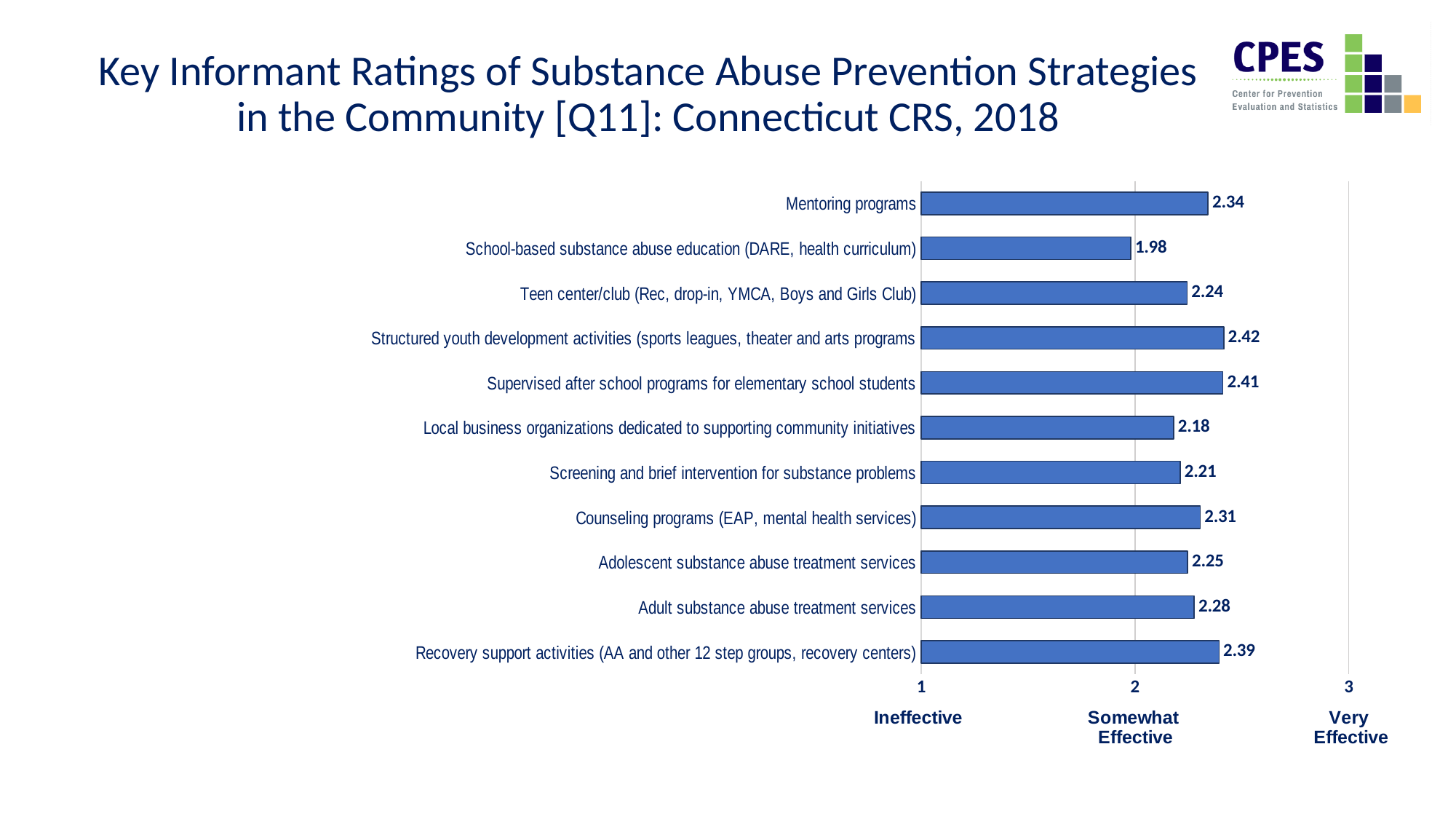
How many strategies are rated in the chart? 11 What is the rating for Mentoring programs? 2.34 Which strategy has the lowest rating? School-based substance abuse education (DARE, health curriculum) What is the rating for Local business organizations dedicated to supporting community initiatives? 2.18 What label is shown at the value 3 on the axis? Very Effective What is the rating for School-based substance abuse education (DARE, health curriculum)? 1.98 Which strategy has the highest rating? Structured youth development activities (sports leagues, theater and arts programs Is the rating for School-based substance abuse education (DARE, health curriculum) greater or less than 2? less What kind of chart is shown on the slide? bar chart What is the difference between the ratings for Mentoring programs and Teen center/club (Rec, drop-in, YMCA, Boys and Girls Club)? 0.10 Which has a higher rating: Counseling programs (EAP, mental health services) or Adult substance abuse treatment services? Counseling programs (EAP, mental health services) What is the rating for Recovery support activities (AA and other 12 step groups, recovery centers)? 2.39